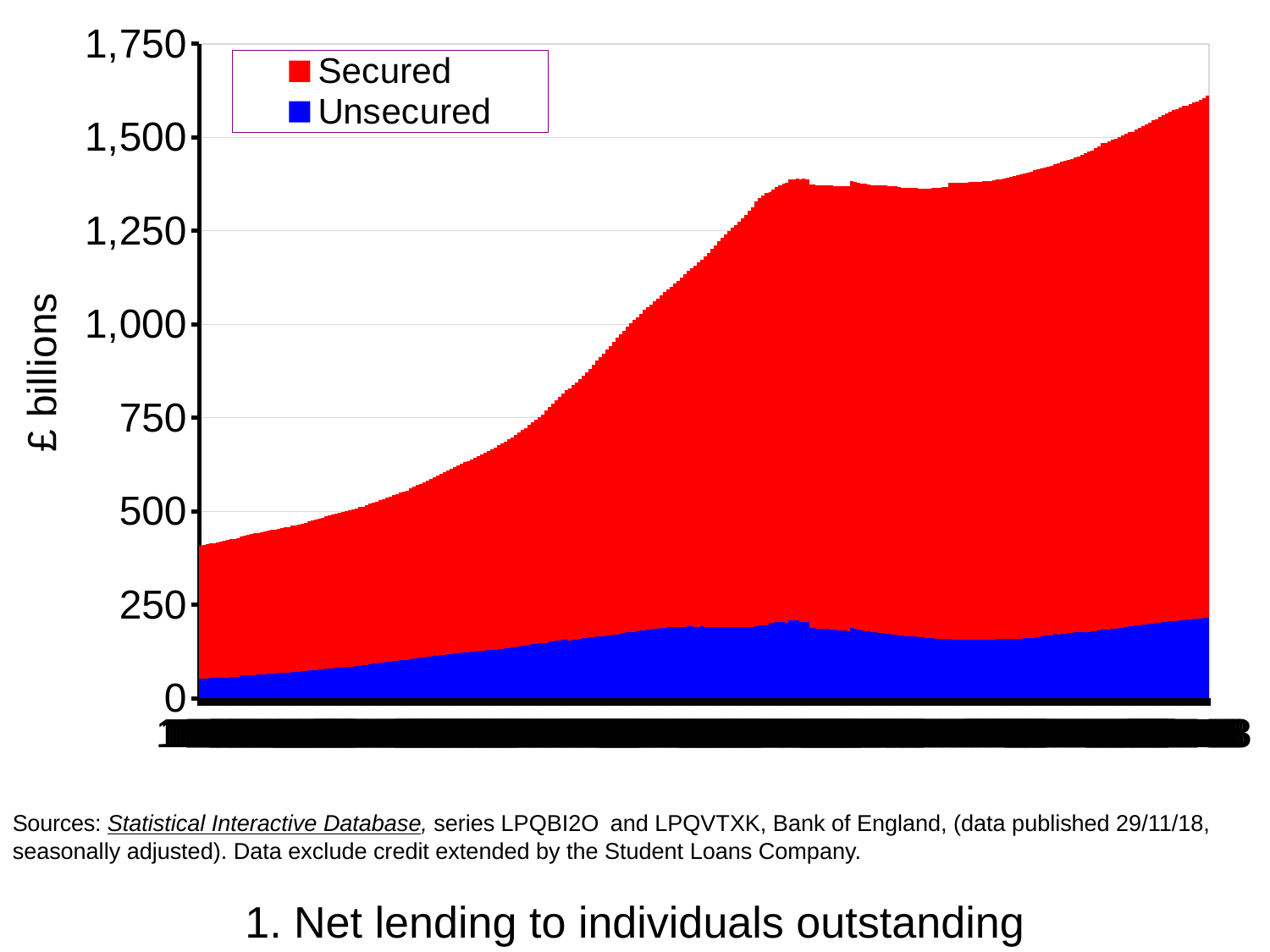
Is the total stacked value at the left-hand end of the chart greater or less than 500? less Which series is shown in red? Secured Is the total stacked value at the right-hand end of the chart greater or less than 1,500? greater How many series does the legend list? 2 Which series is larger at the left-hand end of the chart, Secured or Unsecured? Secured Is the Unsecured value at the right-hand end of the chart greater or less than 250? less What is the label on the vertical axis? £ billions Which series contributes more to the stacked total across the whole chart? Secured Which series is larger at the right-hand end of the chart, Secured or Unsecured? Secured Does the total stacked value generally rise or fall from the left of the chart to the right? rise